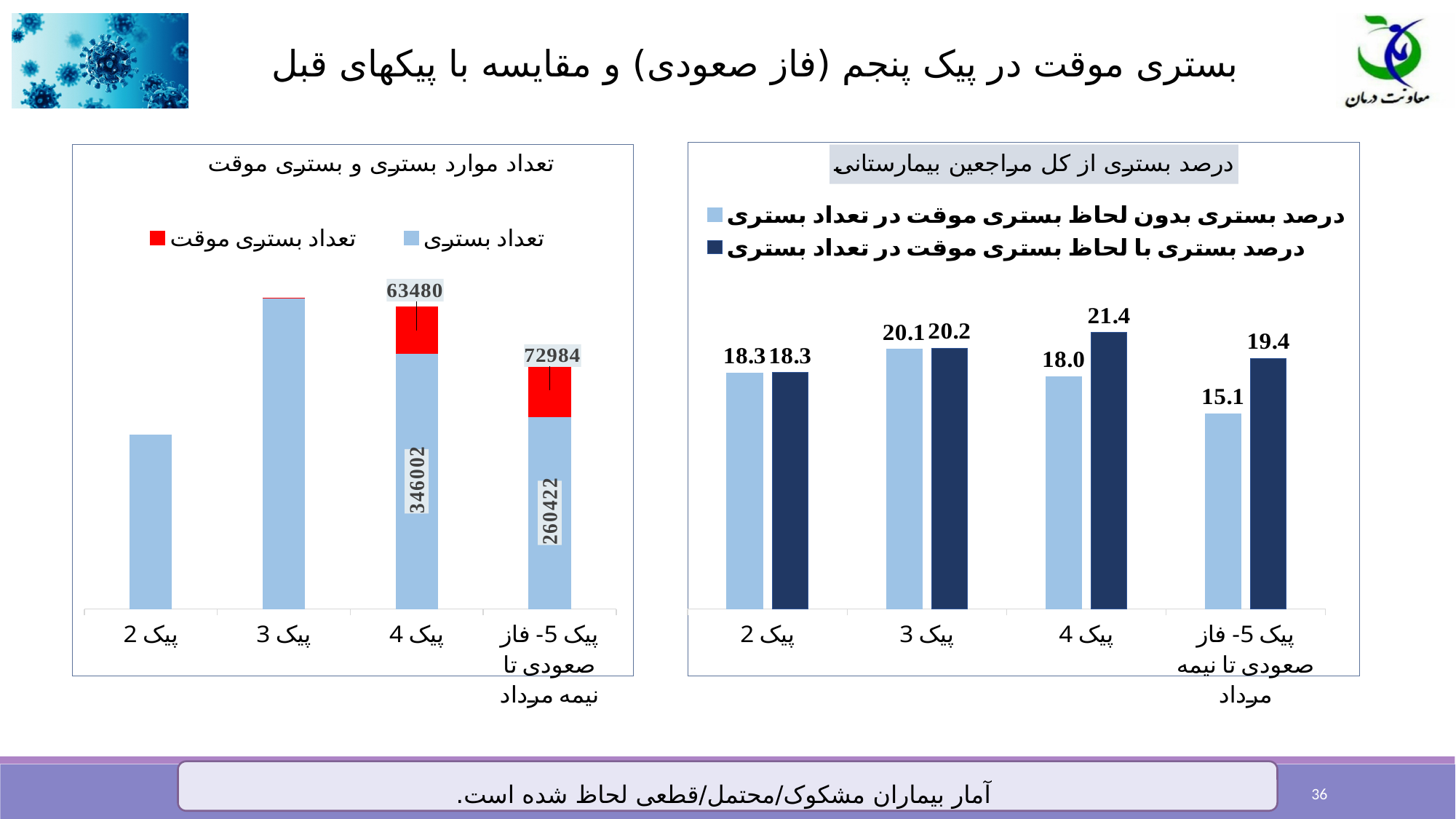
In the right chart, how many categories are shown on the x axis? 4 In the left chart, what is the total of the stacked bar for پیک 4? 409482 In the right chart, what is the difference between the two series for پیک 5- فاز صعودی تا نیمه مرداد? 4.3 What kind of chart is the right chart? bar chart In the left chart, what is the total of the stacked bar for پیک 5- فاز صعودی تا نیمه مرداد? 333406 In the left chart (تعداد موارد بستری و بستری موقت), what is the value of تعداد بستری for پیک 4? 346002 In the left chart, which category has the tallest تعداد بستری bar? پیک 3 In the left chart, how many series does the legend list? 2 In the right chart, which category has the lowest value for درصد بستری بدون لحاظ بستری موقت در تعداد بستری? پیک 5- فاز صعودی تا نیمه مرداد In the right chart, what is the value of درصد بستری بدون لحاظ بستری موقت در تعداد بستری for پیک 5- فاز صعودی تا نیمه مرداد? 15.1 In the right chart (درصد بستری از کل مراجعین بیمارستانی), what is the value of درصد بستری با لحاظ بستری موقت در تعداد بستری for پیک 4? 21.4 In the left chart, what is the value of تعداد بستری موقت for پیک 5- فاز صعودی تا نیمه مرداد? 72984